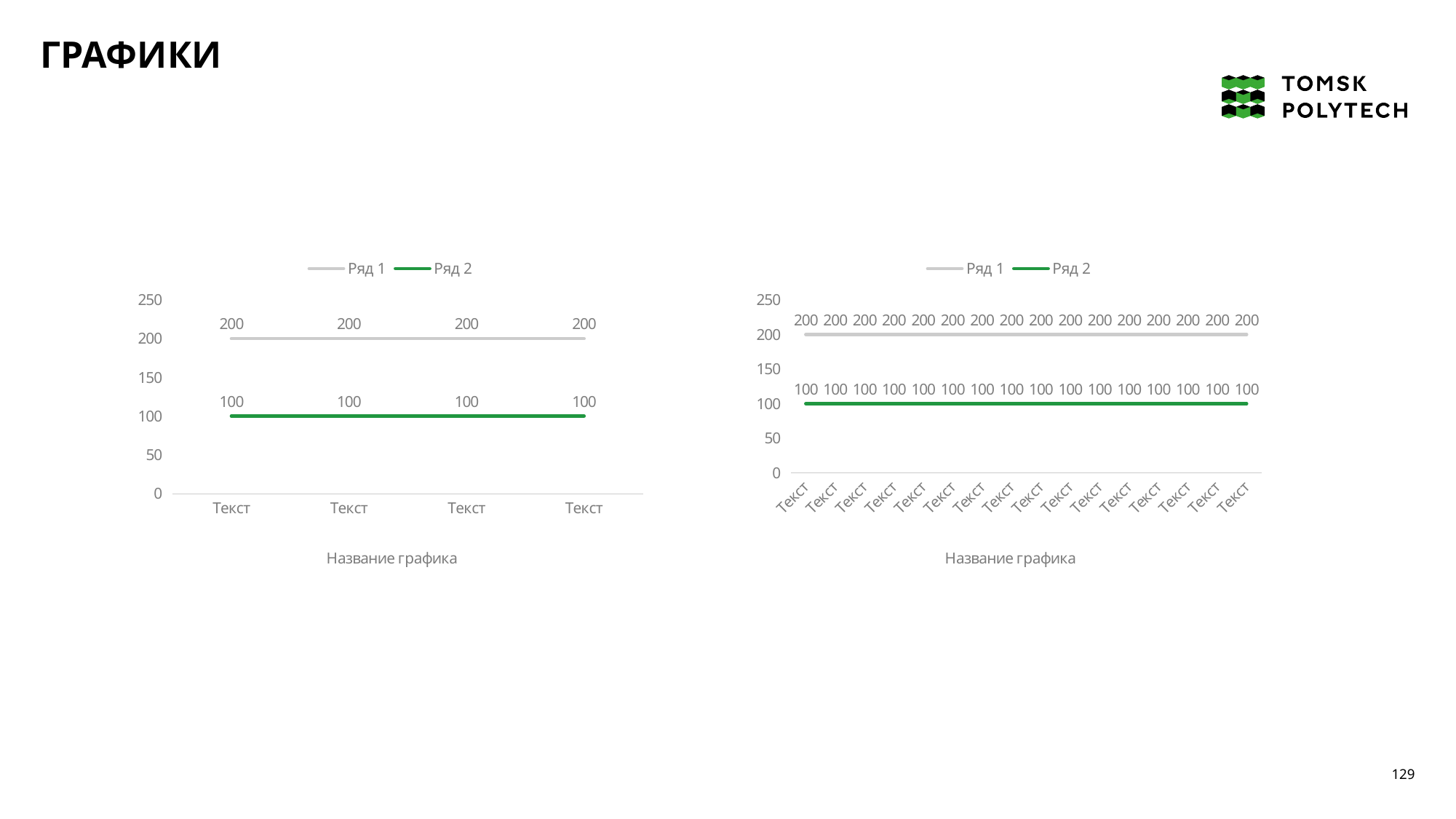
In the left chart, which series has the higher values, Ряд 1 or Ряд 2? Ряд 1 In the right chart, is the value of Ряд 2 greater or less than 150? less In the right chart, what is the difference between the Ряд 1 value and the Ряд 2 value at any category? 100 In the left chart, do the values of Ряд 1 rise, fall, or stay flat along the x axis? stay flat How many categories are plotted along the x axis of the right chart? 16 What kind of chart is the left chart on the slide? line chart In the left chart, what value does Ряд 1 have at each category? 200 How many categories are plotted along the x axis of the left chart? 4 In the right chart, what value does Ряд 2 have at each category? 100 How many series does the legend of the left chart list? 2 What colour is the line for Ряд 2 in the right chart? green In the left chart, what value does Ряд 2 have at each category? 100